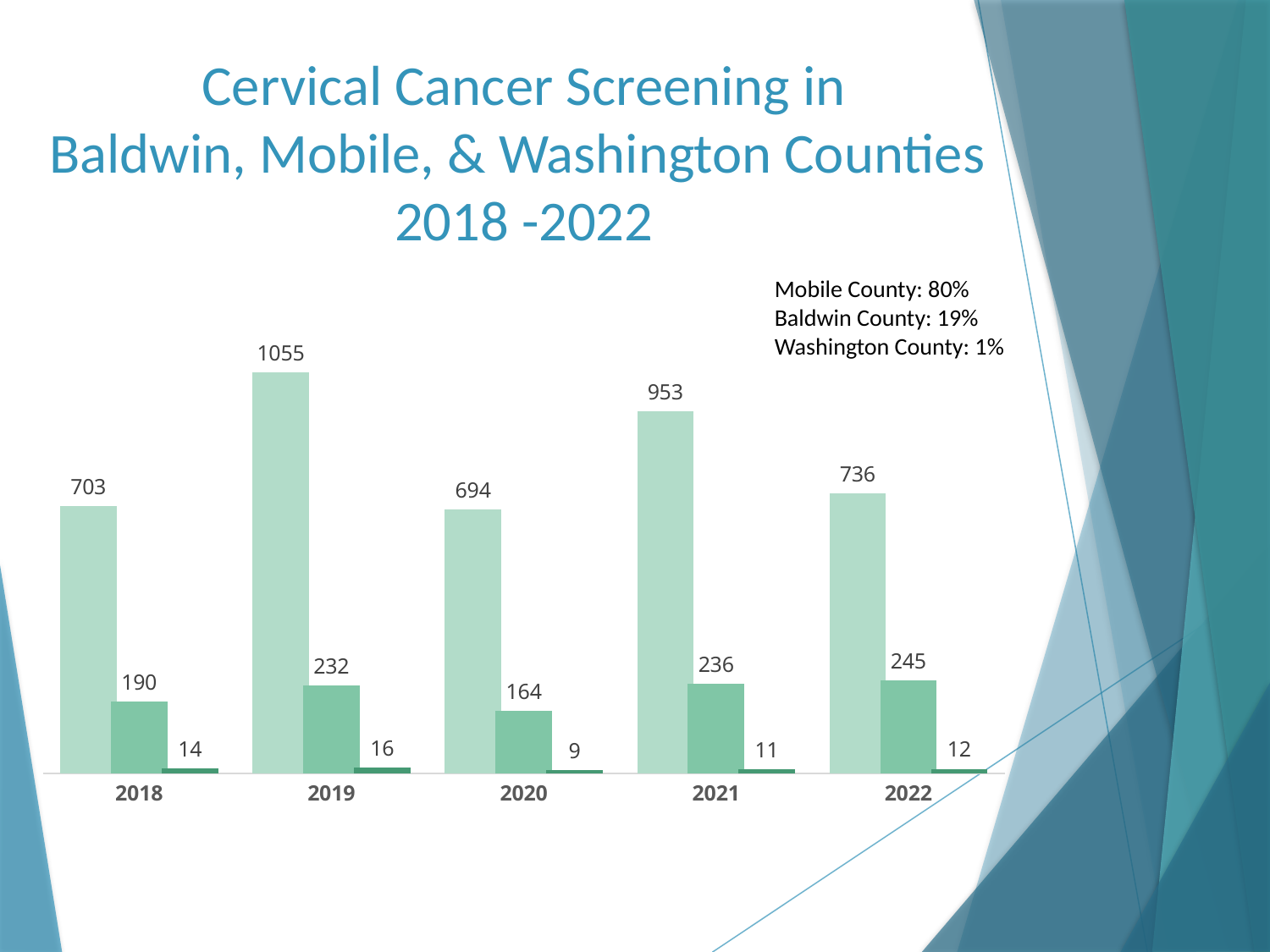
In which year is the tallest (lightest green) bar lowest? 2020 How many years are shown on the x axis? 5 What kind of chart is shown on the slide? Bar chart Which year has the larger medium green bar, 2018 or 2022? 2022 What is the total of the three bar values for 2018? 907 In which year is the tallest (lightest green) bar highest? 2019 What is the difference between the lightest green bar values for 2019 and 2021? 102 What is the value of the middle (medium green) bar for 2021? 236 What is the value of the tallest (lightest green) bar for 2019? 1055 What is the value of the smallest (darkest green) bar for 2020? 9 In which year is the smallest (darkest green) bar highest? 2019 What is the difference between the medium green bar values for 2022 and 2020? 81